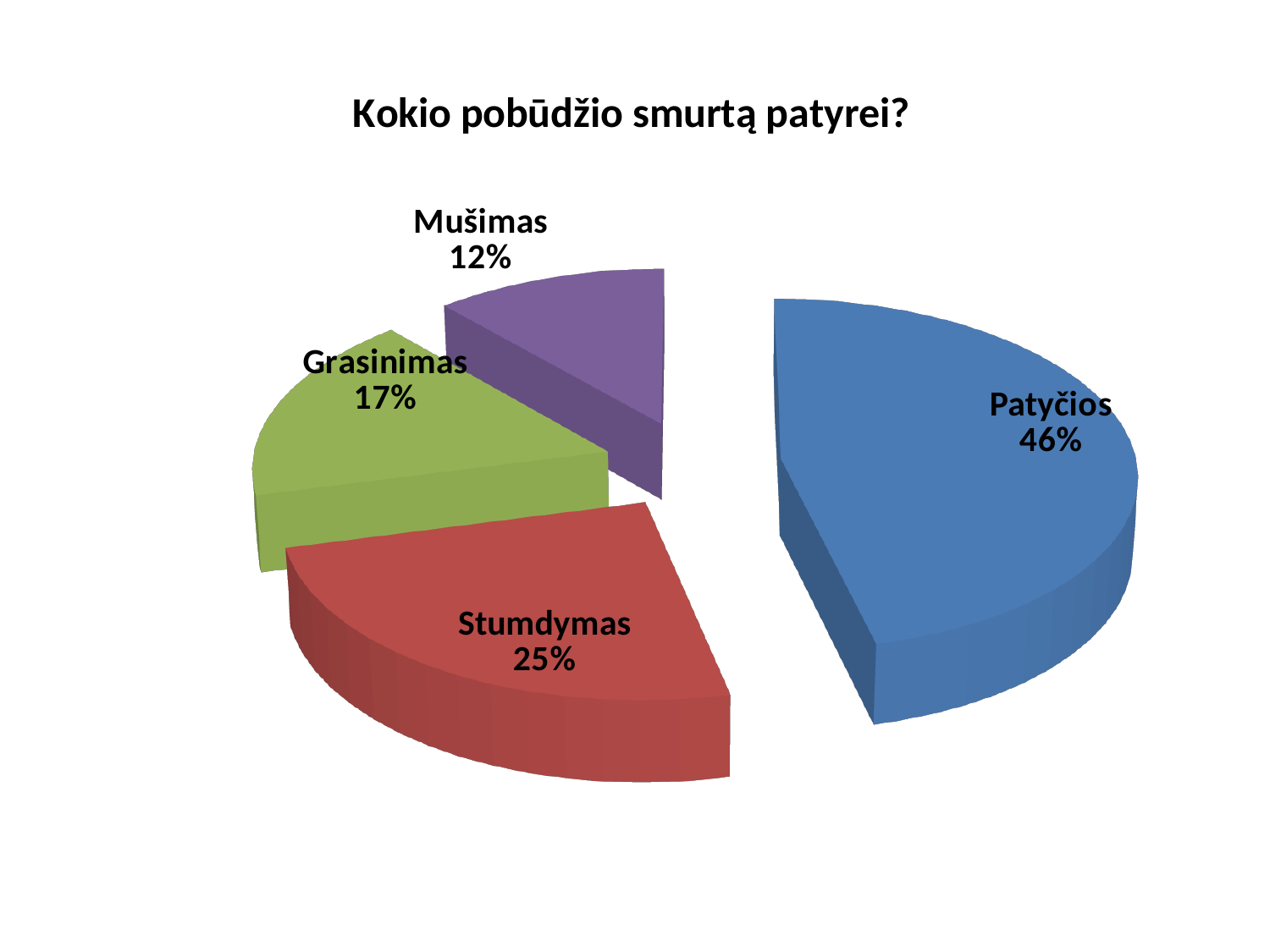
Which is larger, the share for Grasinimas or the share for Mušimas? Grasinimas How many categories are shown in the pie chart? 4 Which category has the smallest share of the pie? Mušimas Which category has the largest share of the pie? Patyčios What percentage is shown for Stumdymas? 25% What percentage is shown for Grasinimas? 17% What colour is the Patyčios slice? blue What kind of chart is shown on the slide? pie chart What percentage is shown for Patyčios? 46% What is the title of the chart? Kokio pobūdžio smurtą patyrei? What is the difference in percentage points between Patyčios and Stumdymas? 21 What percentage is shown for Mušimas? 12%